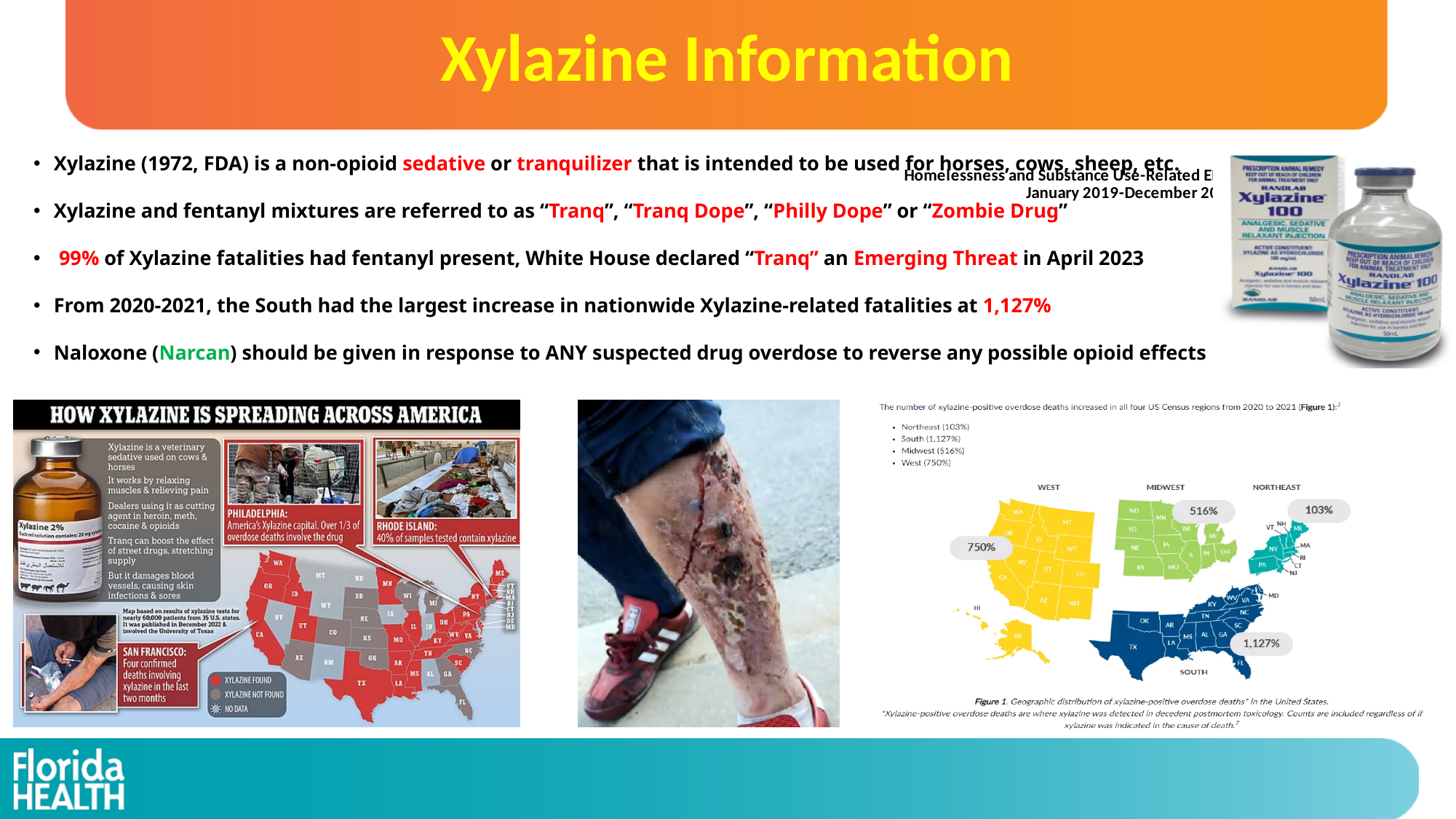
On the 'How Xylazine Is Spreading Across America' map, how many categories does the legend list? 3 On the Figure 1 map of xylazine-positive overdose deaths, what is the difference in percentage points between the West and Midwest increases? 234 On the Figure 1 map of xylazine-positive overdose deaths, how many US Census regions are shown with percentage values? 4 On the Figure 1 map of xylazine-positive overdose deaths, which US Census region had the smallest percentage increase from 2020 to 2021? Northeast On the Figure 1 map of xylazine-positive overdose deaths, what is the percentage increase shown for the West region? 750% On the Figure 1 map of xylazine-positive overdose deaths, what is the percentage increase shown for the Midwest region? 516% On the Figure 1 map of xylazine-positive overdose deaths, what is the percentage increase shown for the South region? 1,127% On the Figure 1 map of xylazine-positive overdose deaths, what is the percentage increase shown for the Northeast region? 103% On the 'How Xylazine Is Spreading Across America' map, what colour indicates states where xylazine was found? Red On the Figure 1 map of xylazine-positive overdose deaths, which US Census region had the largest percentage increase from 2020 to 2021? South On the Figure 1 map of xylazine-positive overdose deaths, what is the difference in percentage points between the South and Northeast increases? 1,024 On the Figure 1 map of xylazine-positive overdose deaths, which region had a larger percentage increase, the West or the Midwest? West